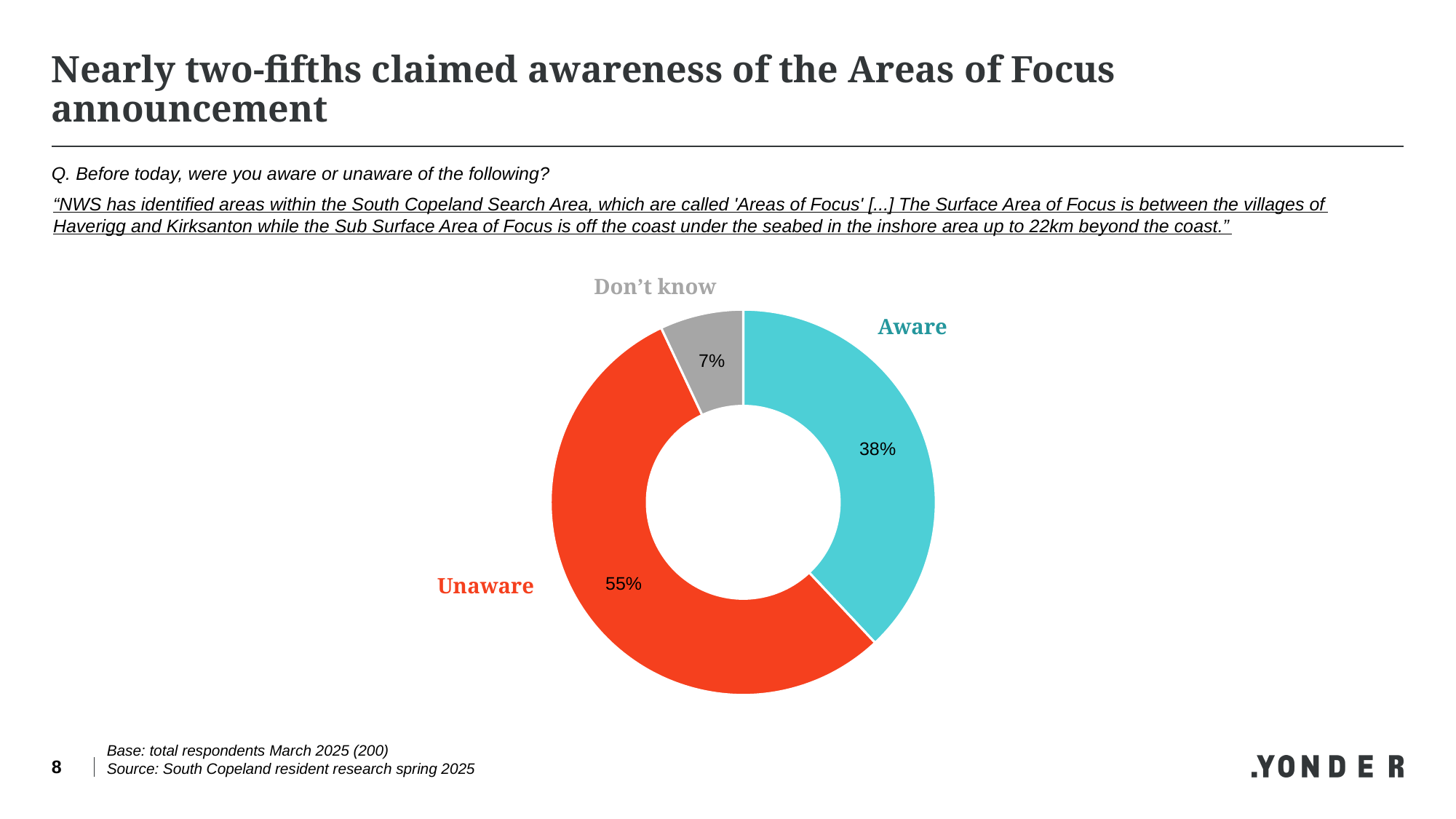
What is the difference in percentage points between Unaware and Aware? 17 Which response has the largest share of the chart? Unaware What percentage of respondents answered 'Don't know'? 7% What colour is the Unaware segment of the chart? Red/orange What is the combined share of Aware and Unaware? 93% How many categories are shown in the chart? 3 What percentage of respondents were unaware of the Areas of Focus announcement? 55% What kind of chart is shown on the slide? Doughnut (pie) chart Which is larger, the share for Aware or the share for Don't know? Aware What is the base size of respondents stated on the slide? 200 Which response has the smallest share of the chart? Don't know What percentage of respondents were aware of the Areas of Focus announcement? 38%